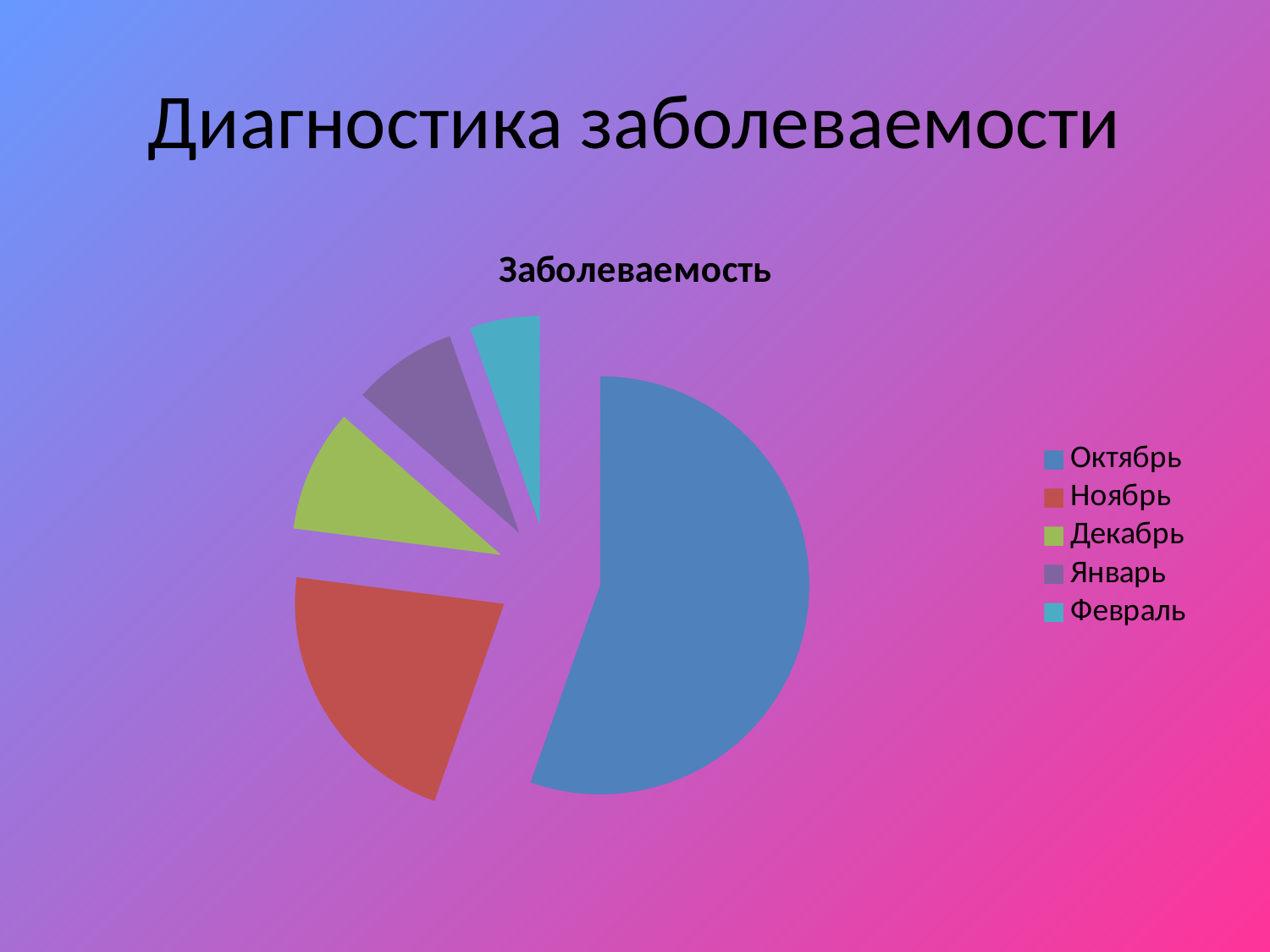
What kind of chart is shown on the slide? Pie chart Which slice is larger, Октябрь or Ноябрь? Октябрь How many entries does the chart legend list? 5 What is the title of the chart? Заболеваемость How many categories (slices) does the pie chart have? 5 Which category is shown in blue in the pie chart? Октябрь Which category has the second-largest slice of the pie? Ноябрь Which slice is larger, Январь or Февраль? Январь Which category has the largest slice of the pie? Октябрь Which category has the smallest slice of the pie? Февраль